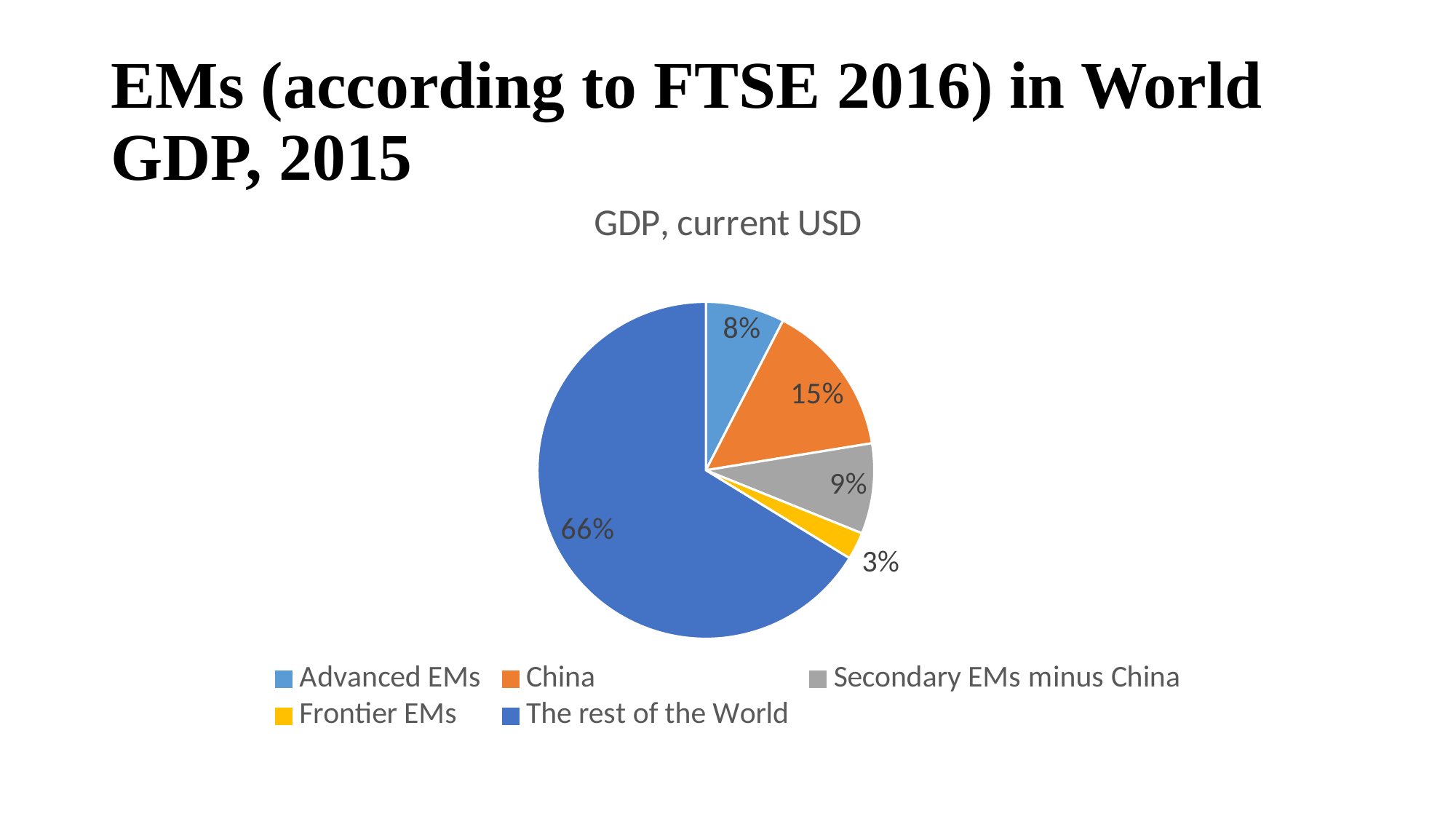
What share of world GDP do Frontier EMs account for? 3% Which category has the smallest slice of the pie? Frontier EMs What share of world GDP does China account for? 15% What share of world GDP does The rest of the World account for? 66% How many categories are shown in the pie chart? 5 What kind of chart is shown on the slide? pie chart Which is larger, the share for China or the share for Secondary EMs minus China? China What share of world GDP do Secondary EMs minus China account for? 9% What is the difference in percentage points between China's share and the Advanced EMs' share? 7 What is the title of the chart? GDP, current USD Which category has the largest slice of the pie? The rest of the World What share of world GDP do Advanced EMs account for? 8%